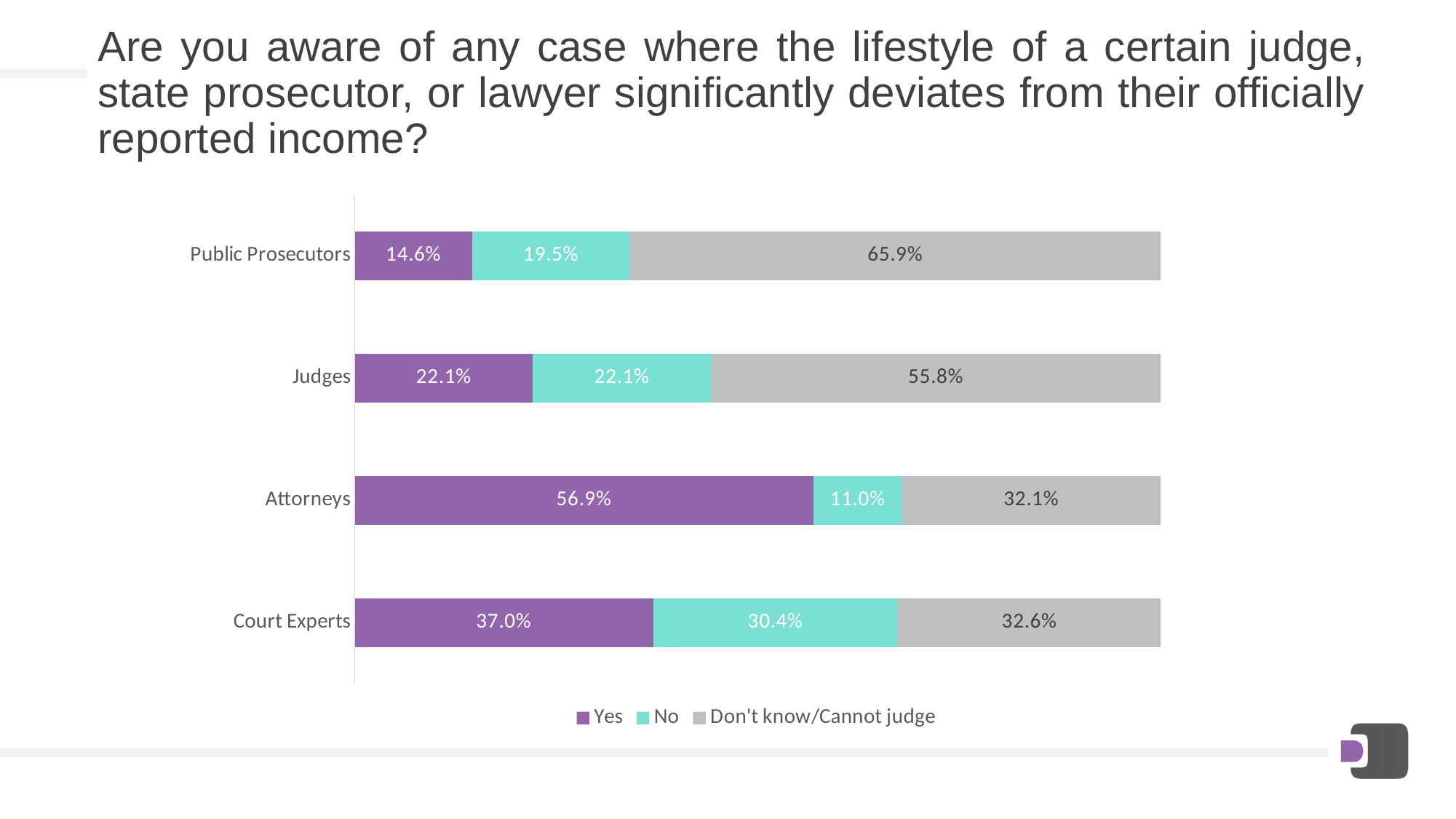
Which colour represents the "No" series in the legend? Teal What is the difference between the "Yes" percentages for Attorneys and Court Experts? 19.9% Which group has the lowest "No" percentage? Attorneys How many series does the legend list? 3 What percentage of Public Prosecutors answered "Don't know/Cannot judge"? 65.9% Which group has the lowest "Yes" percentage? Public Prosecutors Which group has the highest "Yes" percentage? Attorneys What percentage of Attorneys answered "Yes"? 56.9% What percentage of Court Experts answered "No"? 30.4% What kind of chart is shown on the slide? Stacked bar chart How many groups are shown on the chart? 4 Which is larger: the "Don't know/Cannot judge" percentage for Judges or for Court Experts? Judges